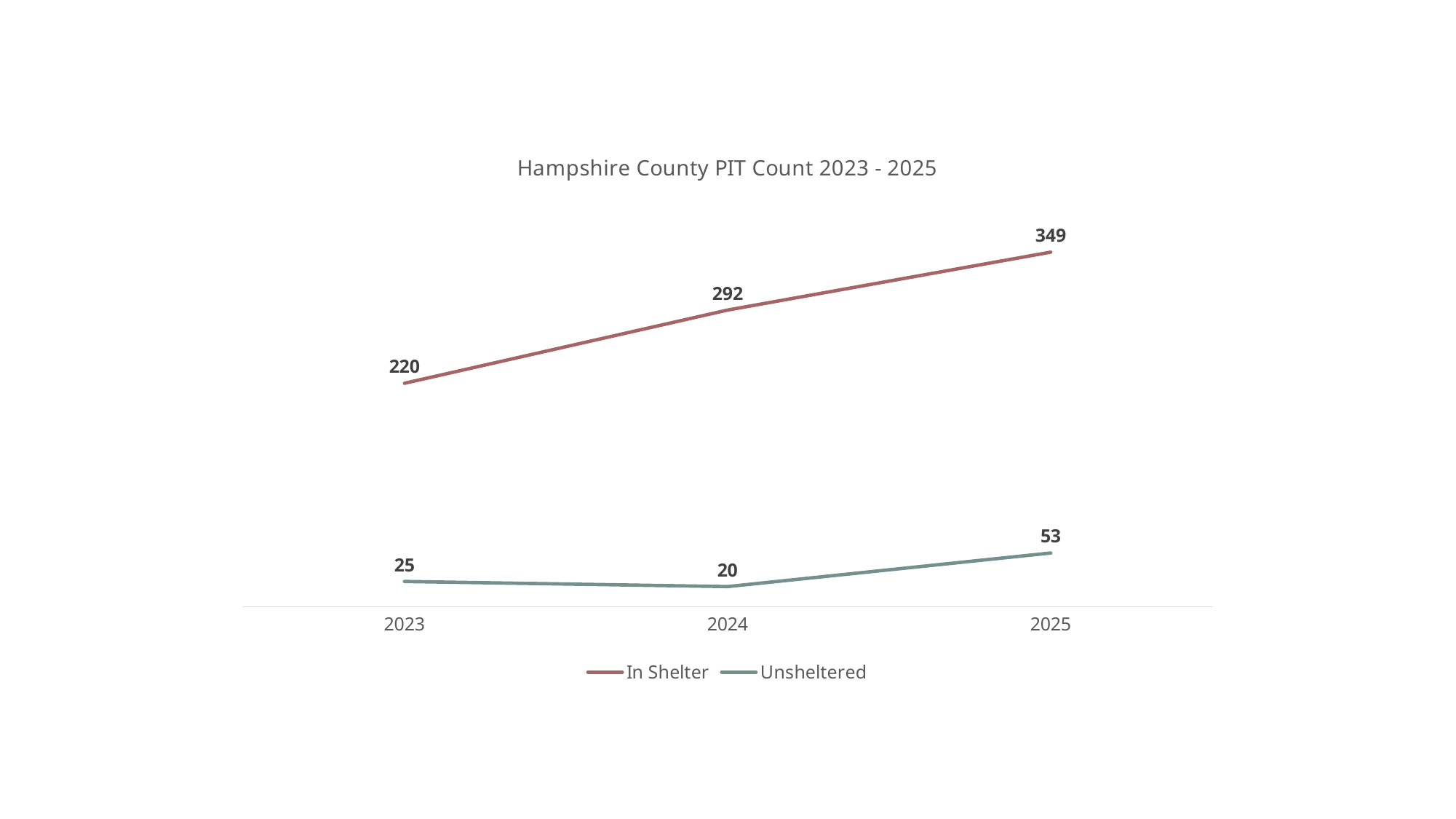
How many years are plotted on the x axis? 3 What is the difference between the Unsheltered values for 2025 and 2024? 33 What is the In Shelter value for 2023? 220 In which year is the Unsheltered value lowest? 2024 What kind of chart is shown? Line chart What is the difference between the In Shelter values for 2025 and 2023? 129 What is the Unsheltered value for 2025? 53 In which year is the In Shelter value highest? 2025 Does the In Shelter series rise or fall from 2023 to 2025? Rise What is the In Shelter value for 2024? 292 Which is larger, the Unsheltered value for 2023 or for 2024? 2023 How many series does the legend list? 2